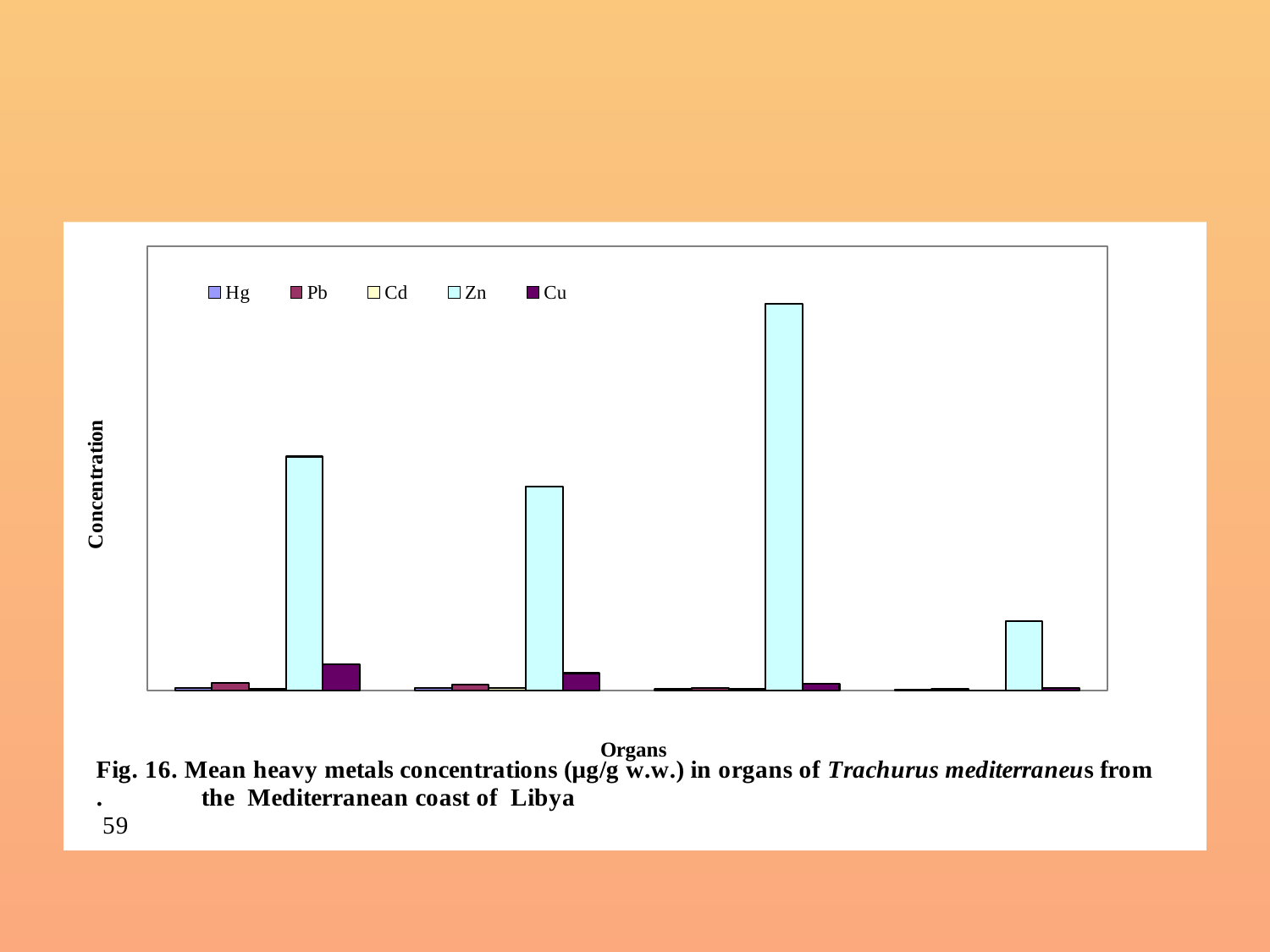
Which metal has the tallest bar in the chart? Zn What is the title of the x axis? Organs How many series does the legend list? 5 What is the title of the y axis? Concentration Which metal has the second-tallest bars in each group? Cu What kind of chart is shown on the slide? bar chart How many groups of bars (organs) are plotted along the x axis? 4